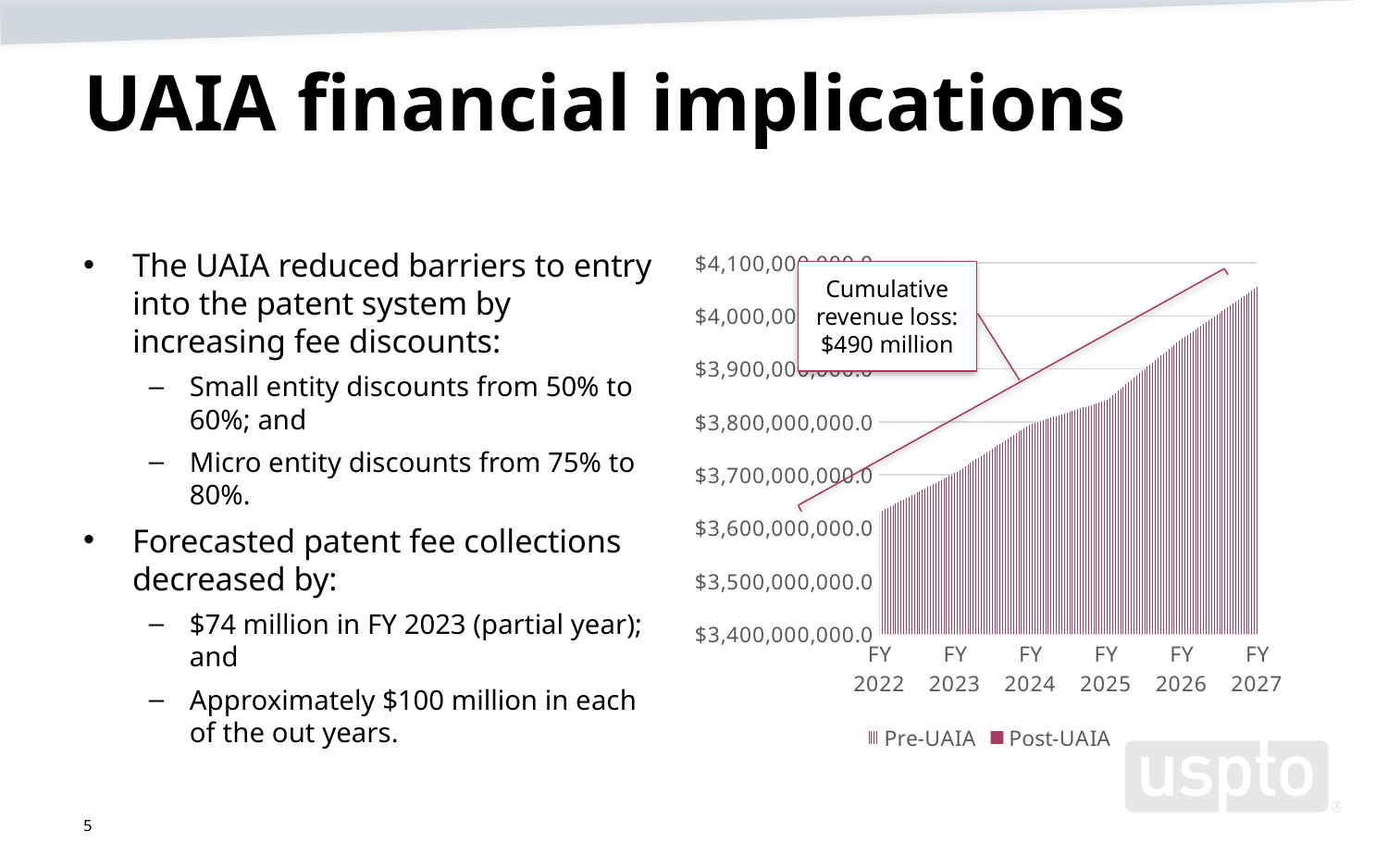
Which fiscal year is the first category on the chart's x axis? FY 2022 Which fiscal year has the higher value for the shaded series, FY 2022 or FY 2027? FY 2027 Is the value of the shaded series at FY 2027 greater or less than $4,000,000,000.0? less Is the value of the shaded series at FY 2022 greater or less than $3,600,000,000.0? greater Is the value of the shaded series at FY 2025 greater or less than $3,800,000,000.0? less What is the lowest tick label on the chart's y axis? $3,400,000,000.0 Do the plotted values rise or fall from FY 2022 to FY 2027? rise What are the two series named in the chart legend? Pre-UAIA and Post-UAIA How many series does the chart legend list? 2 What is the highest tick label on the chart's y axis? $4,100,000,000.0 How many fiscal years are shown on the x axis of the chart? 6 What cumulative revenue loss does the annotation on the chart state? $490 million